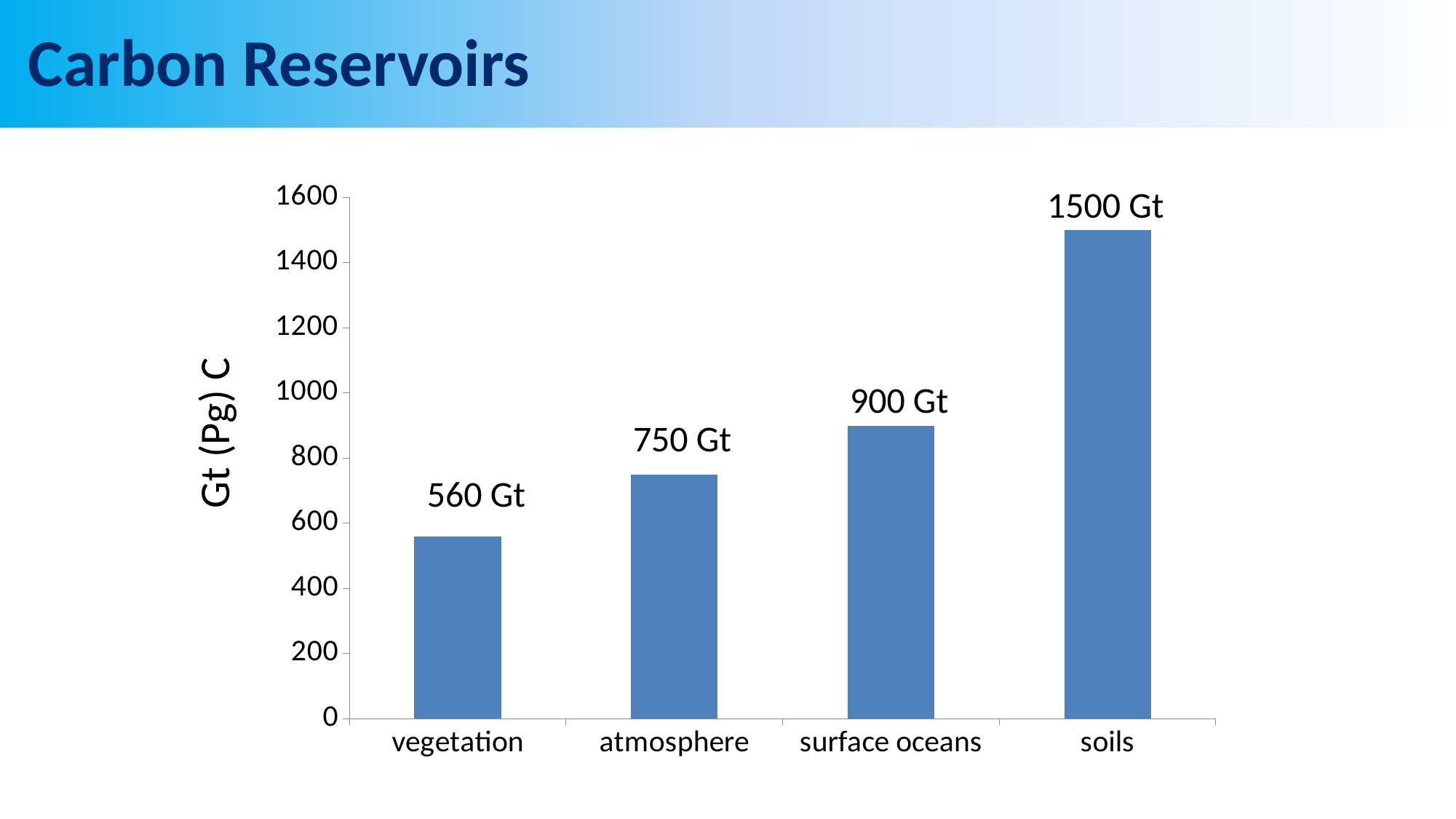
How many categories are shown on the x axis? 4 What is the difference between the values for atmosphere and vegetation? 190 Gt Which category has the highest value? soils What is the difference between the values for soils and surface oceans? 600 Gt What is the value for surface oceans? 900 Gt What is the value for vegetation? 560 Gt What is the value for soils? 1500 Gt What kind of chart is shown on the slide? bar chart Which category has the lowest value? vegetation What is the value for atmosphere? 750 Gt What is the label on the y axis? Gt (Pg) C Which is larger, the value for atmosphere or the value for surface oceans? surface oceans